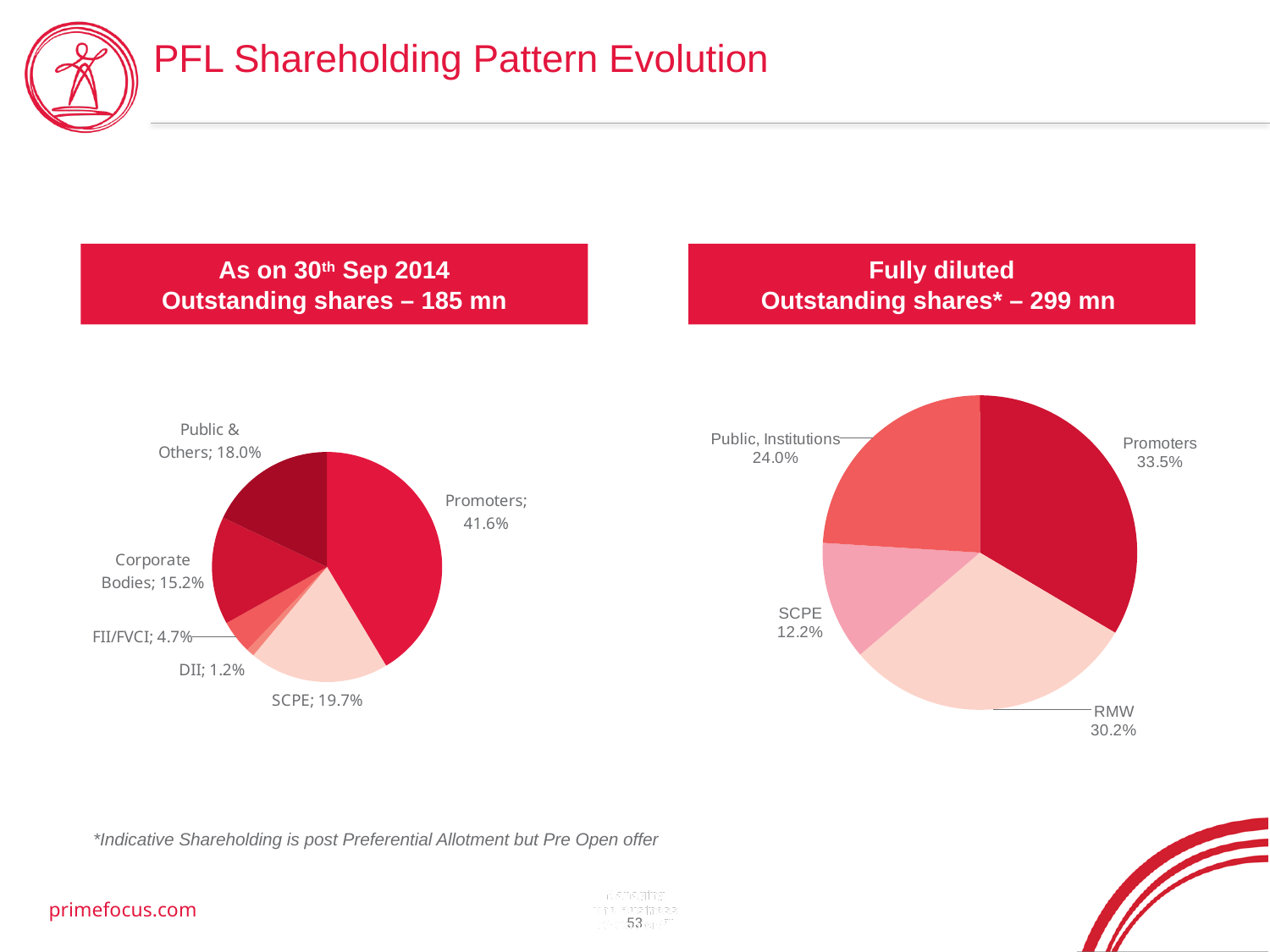
In the 'As on 30th Sep 2014' pie chart, what share does SCPE hold? 19.7% In the 'As on 30th Sep 2014' pie chart, which category has the largest share? Promoters In the 'Fully diluted' pie chart, which category has the largest share? Promoters What type of chart is used on the left side of the slide? Pie chart In the 'Fully diluted' pie chart, what share does Public, Institutions hold? 24.0% In the 'As on 30th Sep 2014' pie chart, which category has the smallest share? DII In the 'As on 30th Sep 2014' pie chart, how many slices are there? 6 In the 'As on 30th Sep 2014' pie chart, what is the difference between the Public & Others share and the Corporate Bodies share? 2.8% In the 'Fully diluted' pie chart, how many slices are there? 4 In the 'Fully diluted' pie chart, which is larger: the SCPE share or the Public, Institutions share? Public, Institutions In the 'Fully diluted' pie chart, what share does RMW hold? 30.2% In the 'As on 30th Sep 2014' pie chart, what share do Promoters hold? 41.6%